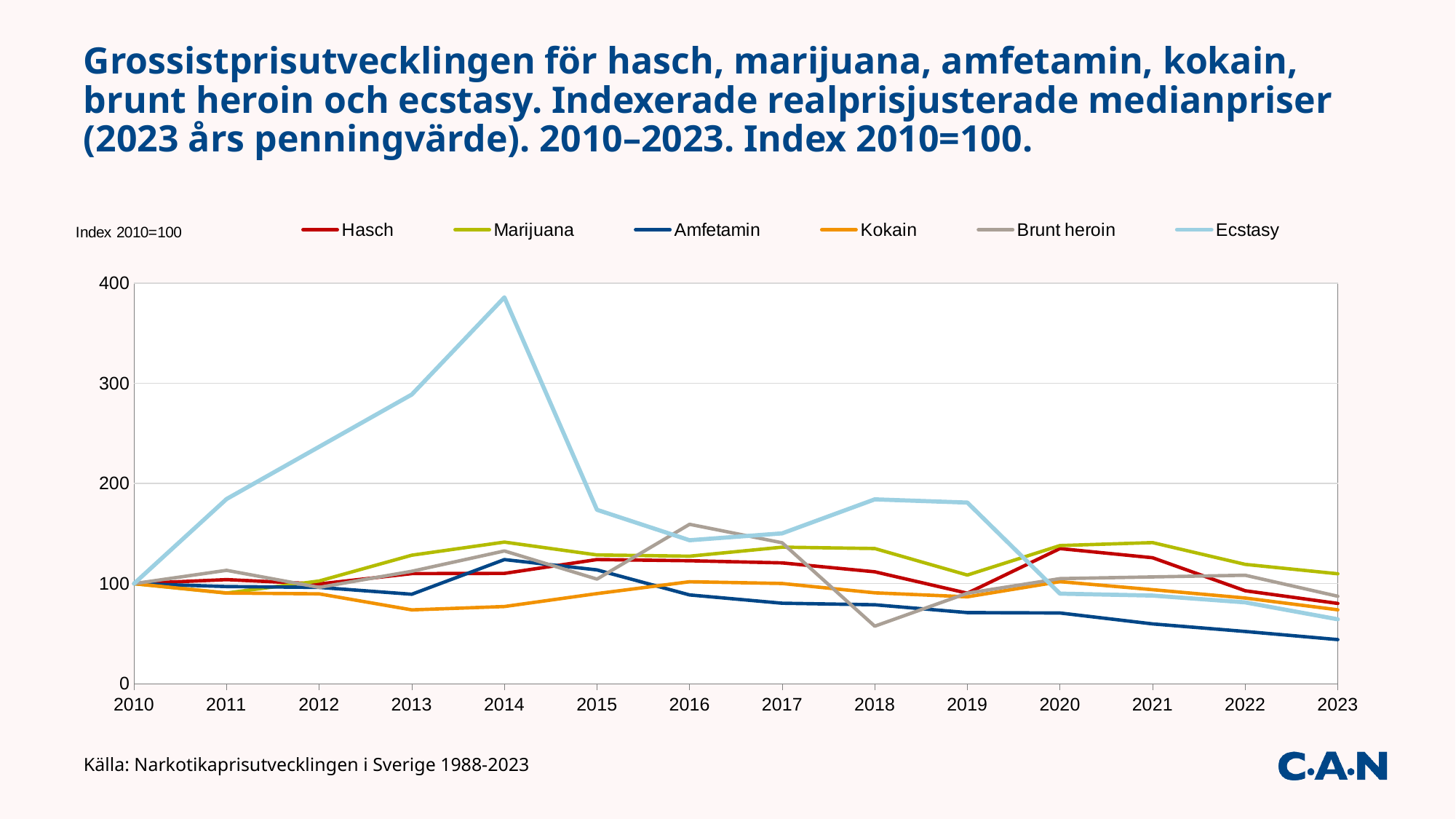
In which year does the Ecstasy line reach its peak? 2014 How many series does the legend list? 6 Which series has the lowest value in 2023? Amfetamin Does the Amfetamin line rise or fall from 2015 to 2023? fall What is the index value for Hasch in 2010? 100 Is the value for Brunt heroin in 2018 greater or less than 100? less Is the value for Ecstasy in 2014 greater or less than 300? greater What colour is the Ecstasy line in the legend? light blue How many years are plotted along the x axis? 14 What kind of chart is shown on the slide? line chart Which series has the highest value in 2014? Ecstasy Is the value for Amfetamin in 2023 greater or less than 100? less